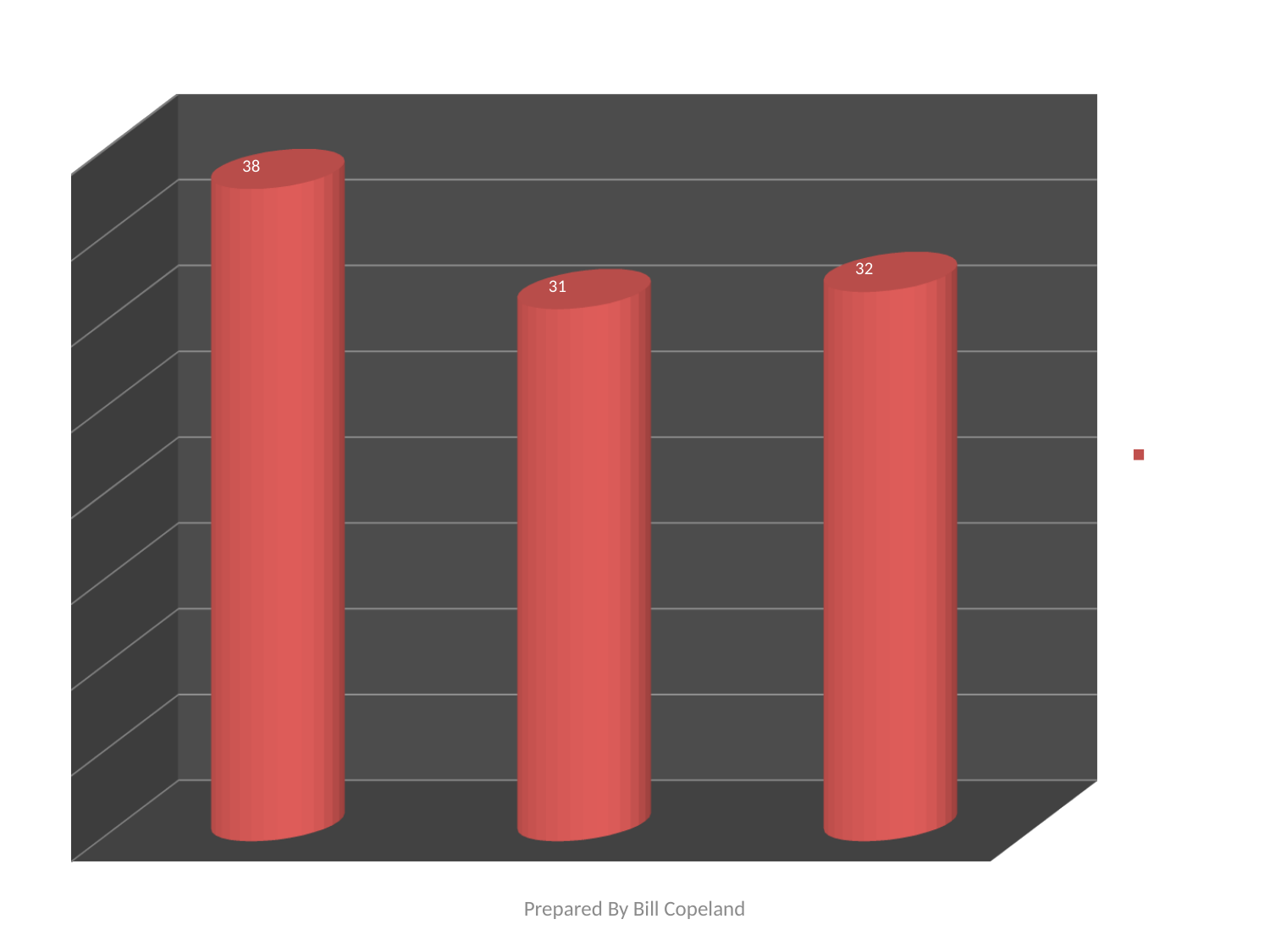
What kind of chart is shown on the slide? bar chart Which bar has the lowest value: the leftmost, middle, or rightmost? middle What is the difference between the leftmost bar's value and the middle bar's value? 7 What is the value shown on the rightmost bar? 32 How many bars are plotted in the chart? 3 What is the total of the three bar values? 101 Which is larger, the value of the leftmost bar or the value of the rightmost bar? leftmost bar What is the difference between the rightmost bar's value and the middle bar's value? 1 What is the value shown on the leftmost bar? 38 What is the value shown on the middle bar? 31 What colour are the bars in the chart? red Which bar has the highest value: the leftmost, middle, or rightmost? leftmost